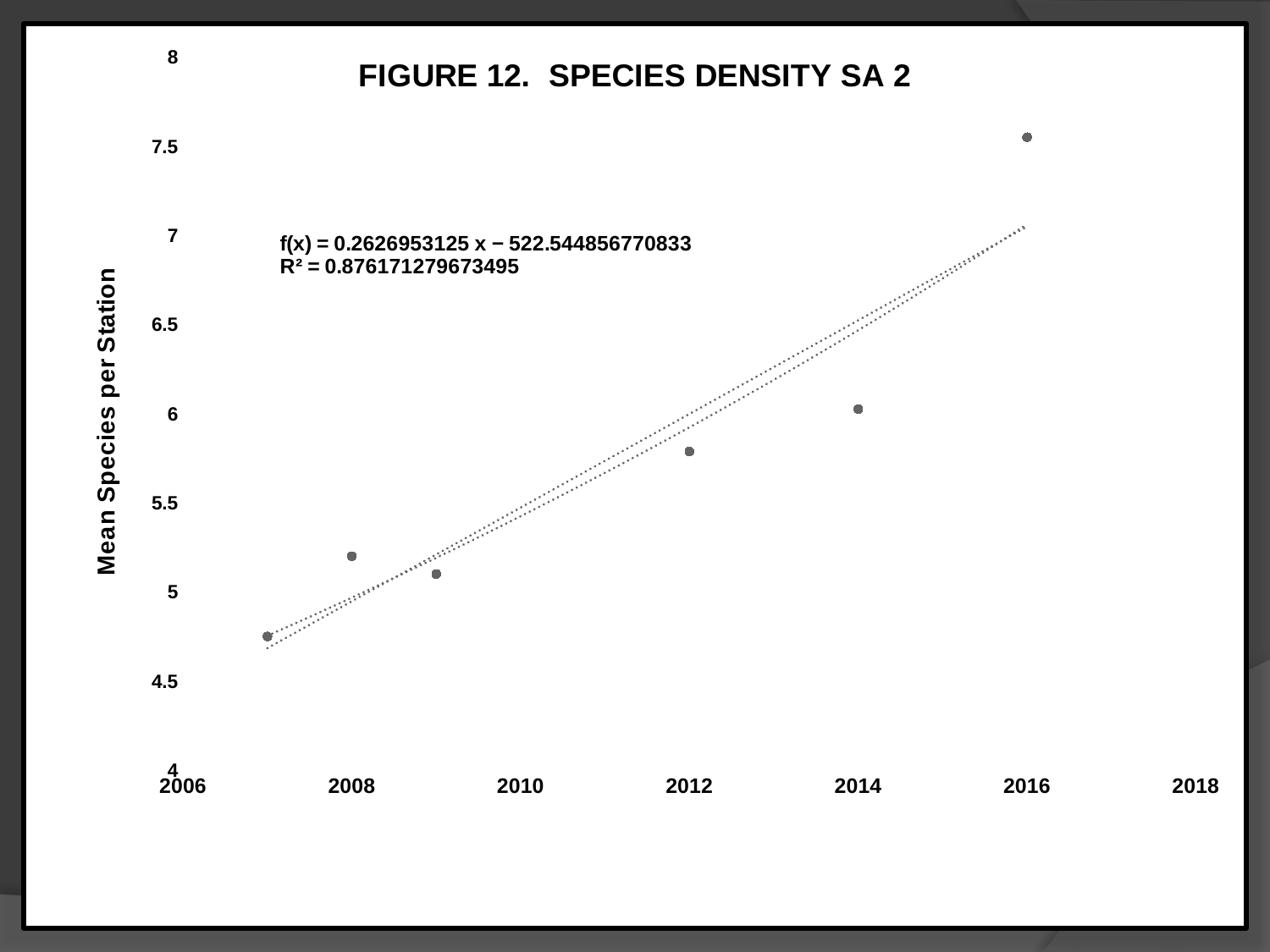
What R² value is printed for the trendline? 0.876171279673495 Is the value for 2007 greater or less than 5? less Which year has the highest mean species per station? 2016 How many data points are plotted in the chart? 6 Is the value for 2012 greater or less than 5.5? greater Do the values generally rise or fall from 2007 to 2016? rise Is the value for 2016 greater or less than 7? greater Which year has a larger value, 2014 or 2016? 2016 Which year has the lowest mean species per station? 2007 What kind of chart is shown on the slide? scatter chart What is the title of the chart? FIGURE 12. SPECIES DENSITY SA 2